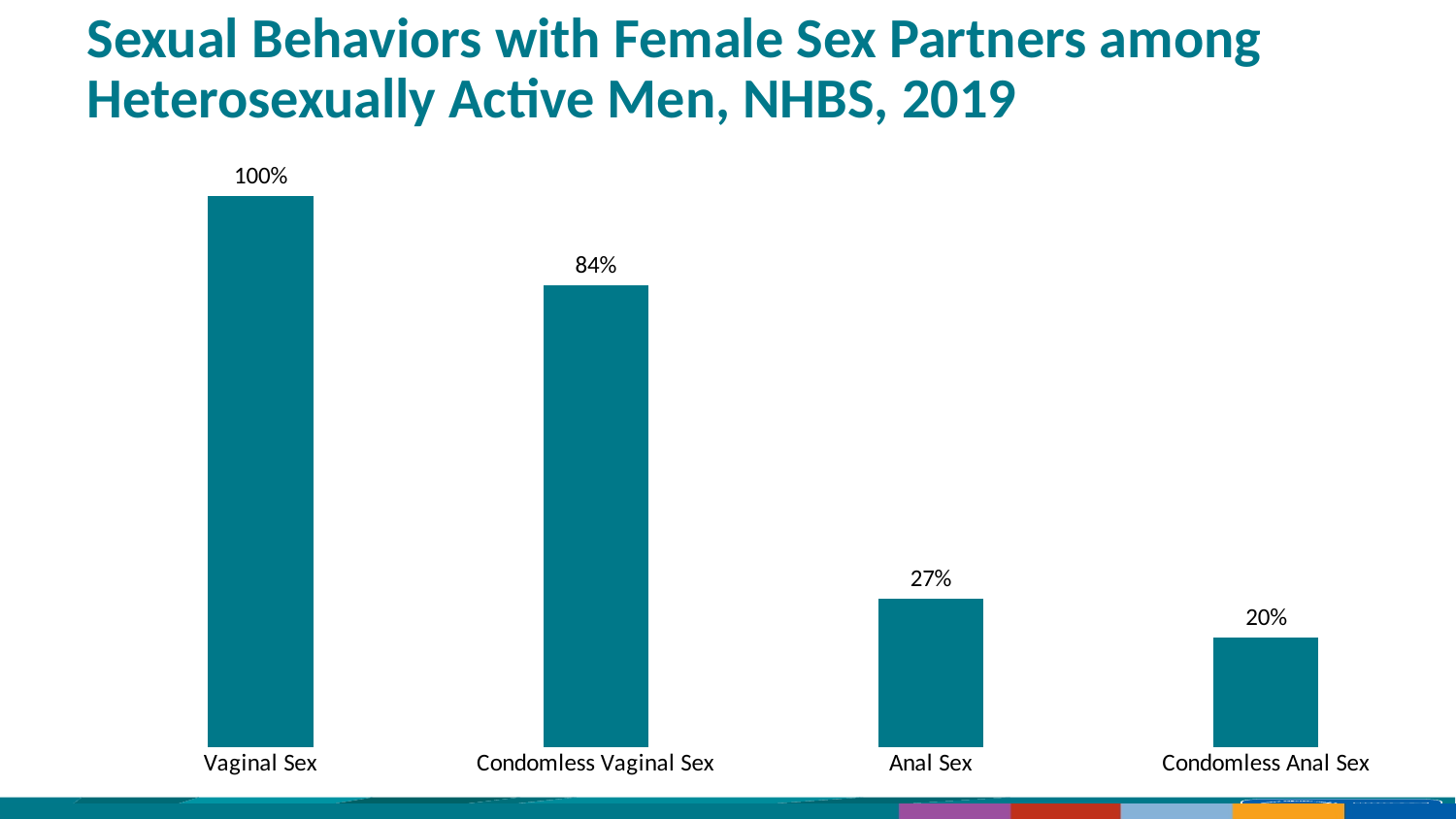
Which is larger, the value for Condomless Vaginal Sex or the value for Anal Sex? Condomless Vaginal Sex What is the difference between the values for Vaginal Sex and Condomless Vaginal Sex? 16% Which category has the highest value? Vaginal Sex What percentage is shown for Condomless Vaginal Sex? 84% What percentage is shown for Condomless Anal Sex? 20% How many categories are shown in the chart? 4 What kind of chart is shown on the slide? Bar chart What is the difference between the values for Anal Sex and Condomless Anal Sex? 7% Do the values rise or fall from left to right across the categories? Fall What percentage is shown for Anal Sex? 27% Which category has the lowest value? Condomless Anal Sex What percentage is shown for Vaginal Sex? 100%